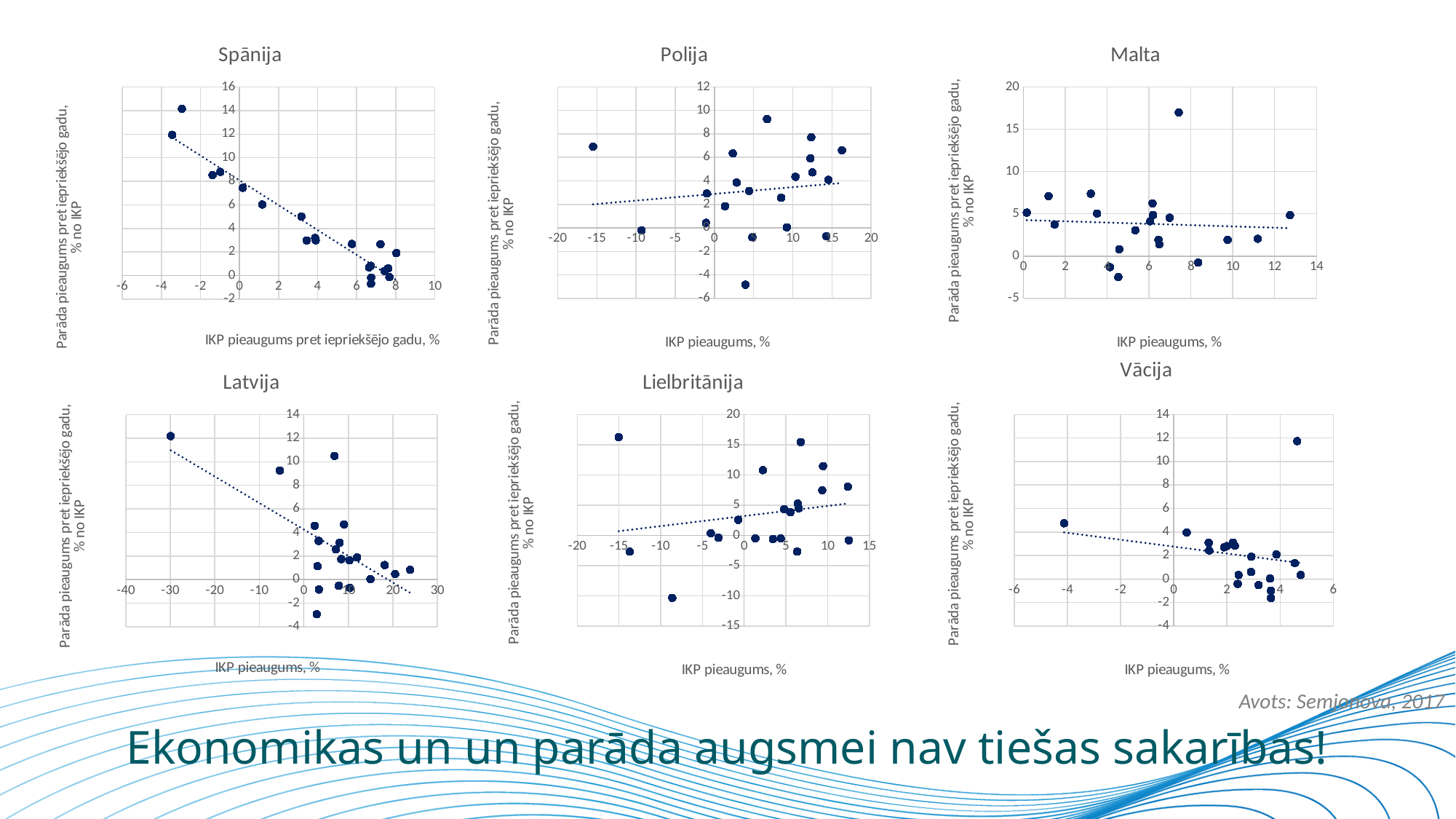
What is the x-axis title of the Malta chart? IKP pieaugums, % In the Spānija chart, is the highest plotted point greater or less than 12 on the y axis? greater In the Latvija chart, does the dotted trend line rise or fall along the x axis? fall In the Vācija chart, does the dotted trend line rise or fall along the x axis? fall What kind of chart is the Spānija chart? scatter chart In the Vācija chart, is the highest plotted point greater or less than 10 on the y axis? greater In the Polija chart, is the lowest plotted point greater or less than -4 on the y axis? less How many charts are shown on the slide? 6 In the Polija chart, does the dotted trend line rise or fall along the x axis? rise